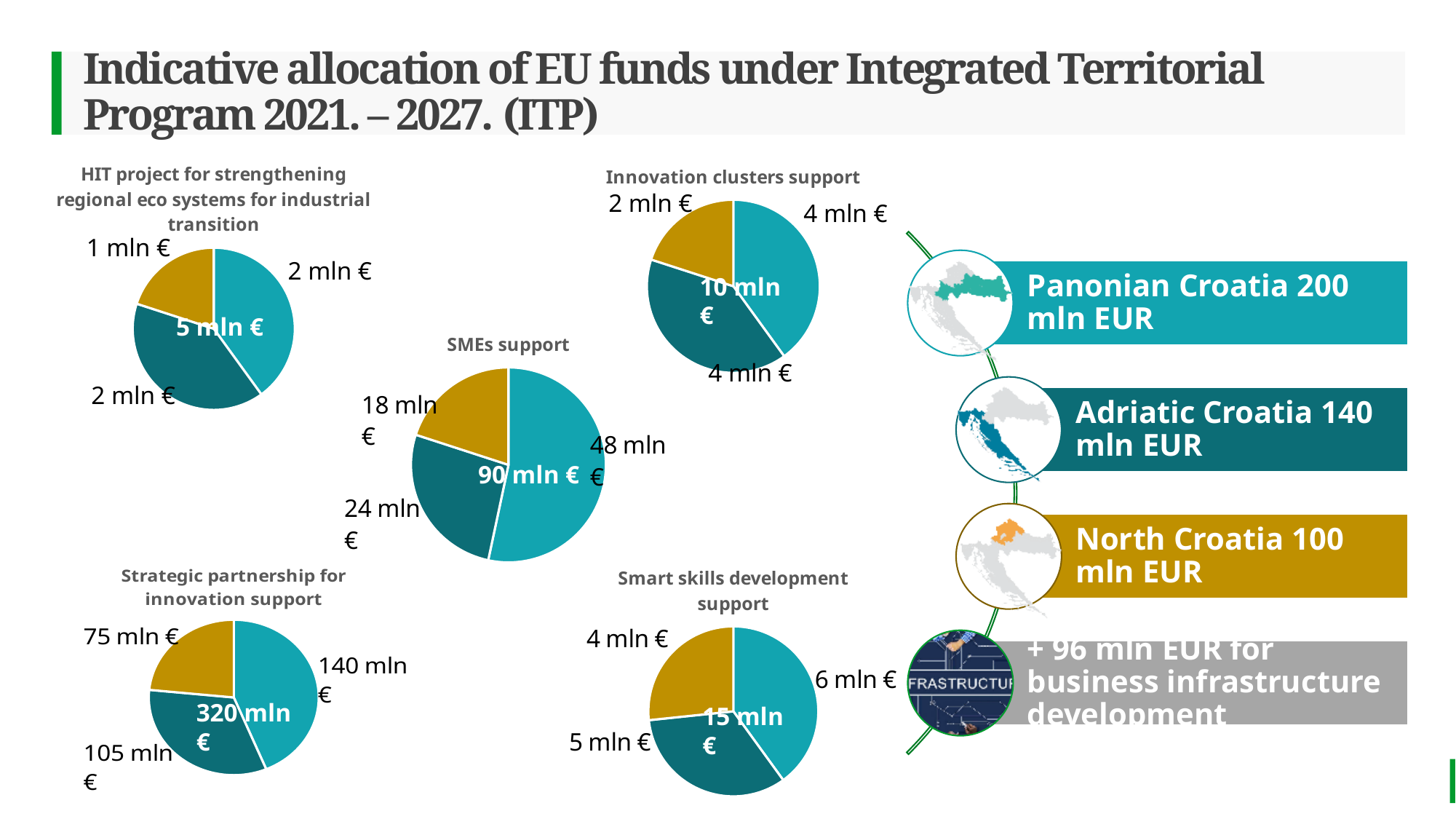
In the 'Innovation clusters support' pie chart, what share of the 10 mln € total does the 2 mln € slice represent? 20% What total is printed in the centre of the 'HIT project for strengthening regional eco systems for industrial transition' pie chart? 5 mln € How many pie charts are on the slide? 5 In the 'SMEs support' pie chart, what is the value of the largest slice? 48 mln € In the 'SMEs support' pie chart, what is the value of the smallest slice? 18 mln € In the 'Smart skills development support' pie chart, what share of the 15 mln € total does the 6 mln € slice represent? 40% How many slices does the 'HIT project for strengthening regional eco systems for industrial transition' pie chart have? 3 What total is printed in the centre of the 'Strategic partnership for innovation support' pie chart? 320 mln € In the 'SMEs support' pie chart, which is larger: the 24 mln € slice or the 18 mln € slice? 24 mln € In the 'Smart skills development support' pie chart, what is the value of the smallest slice? 4 mln € In the 'Strategic partnership for innovation support' pie chart, what is the difference between the 140 mln € slice and the 105 mln € slice? 35 mln € What kind of charts are shown on the slide? Pie charts